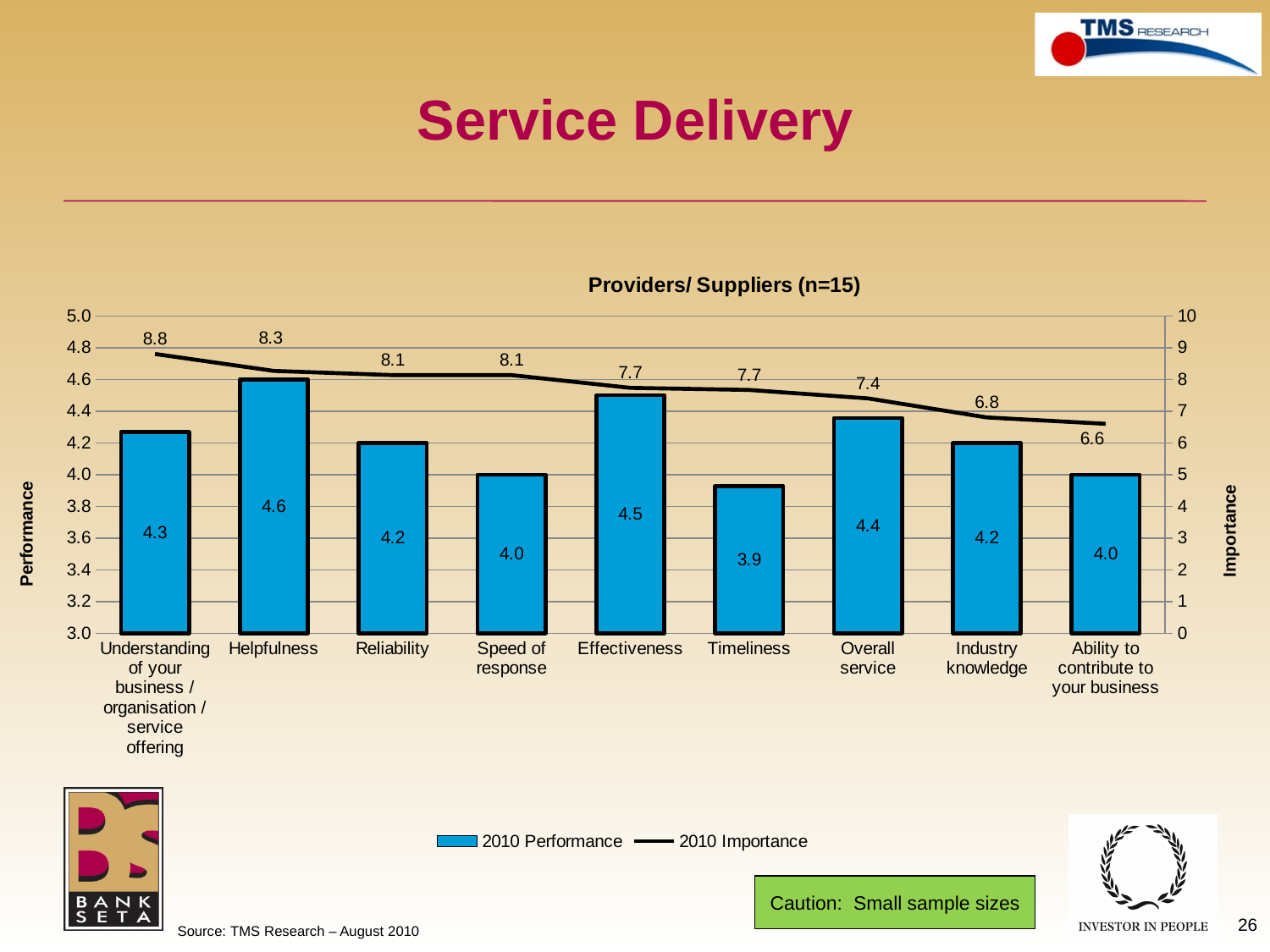
Which has a higher 2010 Performance value, Effectiveness or Overall service? Effectiveness What is the 2010 Performance value for Timeliness? 3.9 What is the 2010 Importance value for Ability to contribute to your business? 6.6 How many series does the legend list? 2 What is the 2010 Importance value for Understanding of your business / organisation / service offering? 8.8 Which category has the highest 2010 Performance value? Helpfulness Does the 2010 Importance line generally rise or fall from left to right across the categories? fall What is the 2010 Performance value for Helpfulness? 4.6 Which category has the lowest 2010 Performance value? Timeliness Which category has the lowest 2010 Importance value? Ability to contribute to your business How many categories are shown on the x axis of the chart? 9 What is the difference between the 2010 Performance values for Helpfulness and Timeliness? 0.7